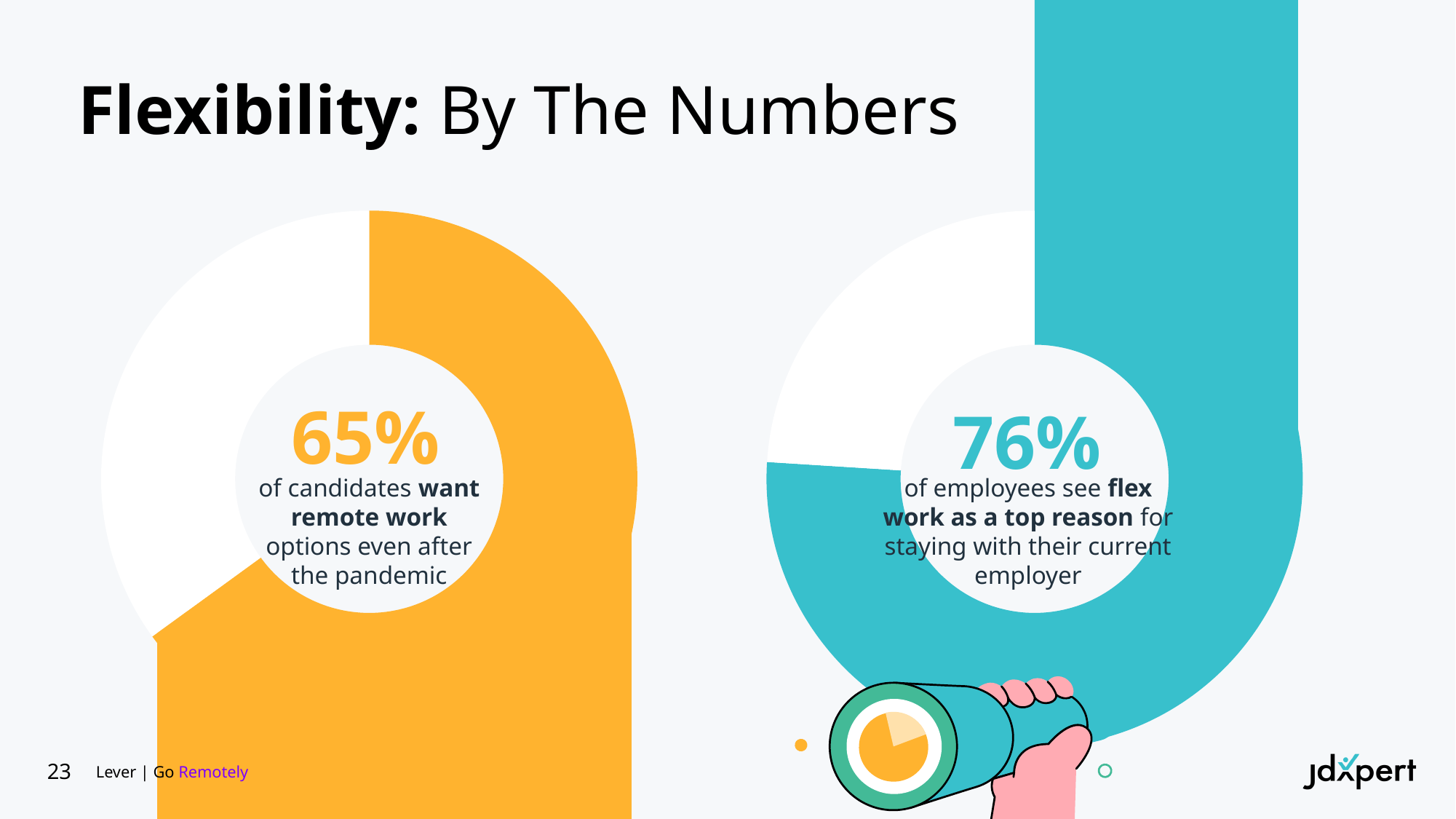
On the right chart, what percentage of employees see flex work as a top reason for staying with their current employer? 76% What is the title of the slide containing the two donut charts? Flexibility: By The Numbers What kind of chart is used on the left to show the 65% figure? Donut (pie) chart On the left chart, what percentage of candidates want remote work options even after the pandemic? 65% On the right chart, what share of the donut is filled in teal? 76% Is the value shown on the left chart greater or less than 50%? greater What is the difference between the percentage shown on the right chart (76%) and the percentage shown on the left chart (65%)? 11 percentage points How many donut charts are shown on the slide? 2 Which is larger: the percentage on the left chart (candidates wanting remote work) or the percentage on the right chart (employees seeing flex work as a top reason to stay)? The right chart, 76% What kind of chart is used on the right to show the 76% figure? Donut (pie) chart On the left chart, what share of the donut is filled in orange? 65% What colour is the filled portion of the right chart? Teal